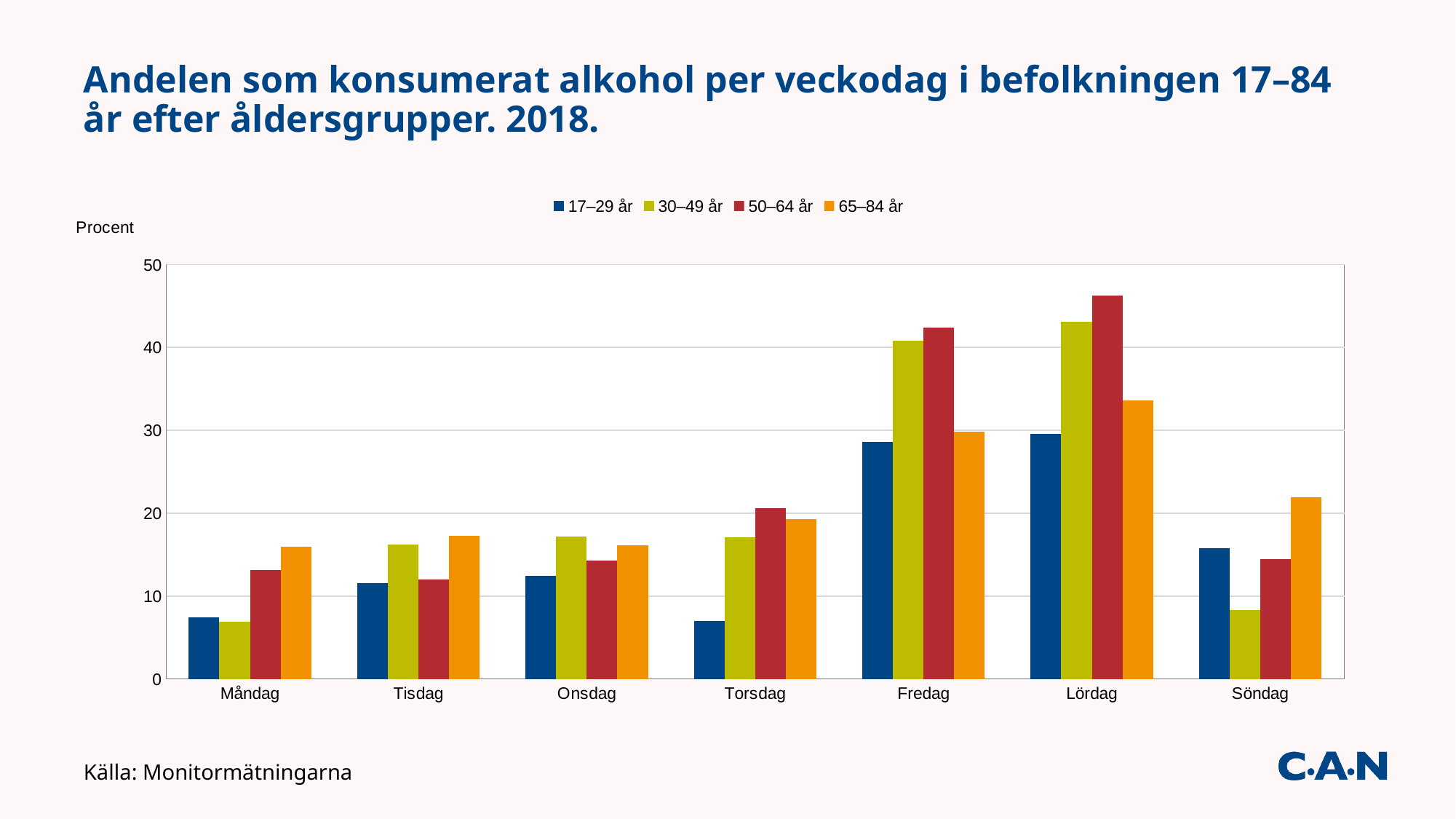
On Fredag, which is larger: the value for 30–49 år or the value for 65–84 år? 30–49 år On Söndag, which age group has the lowest value? 30–49 år What kind of chart is shown on the slide? Bar chart How many series does the legend list? 4 For the 50–64 år series, which weekday has the highest value? Lördag How many weekdays are shown on the x axis? 7 Is the value for 17–29 år on Torsdag greater or less than 10? less What source is cited below the chart? Monitormätningarna Is the value for 50–64 år on Fredag greater or less than 40? greater On Lördag, which age group has the highest value? 50–64 år Is the value for 65–84 år on Söndag greater or less than 20? greater What is the label on the vertical axis? Procent